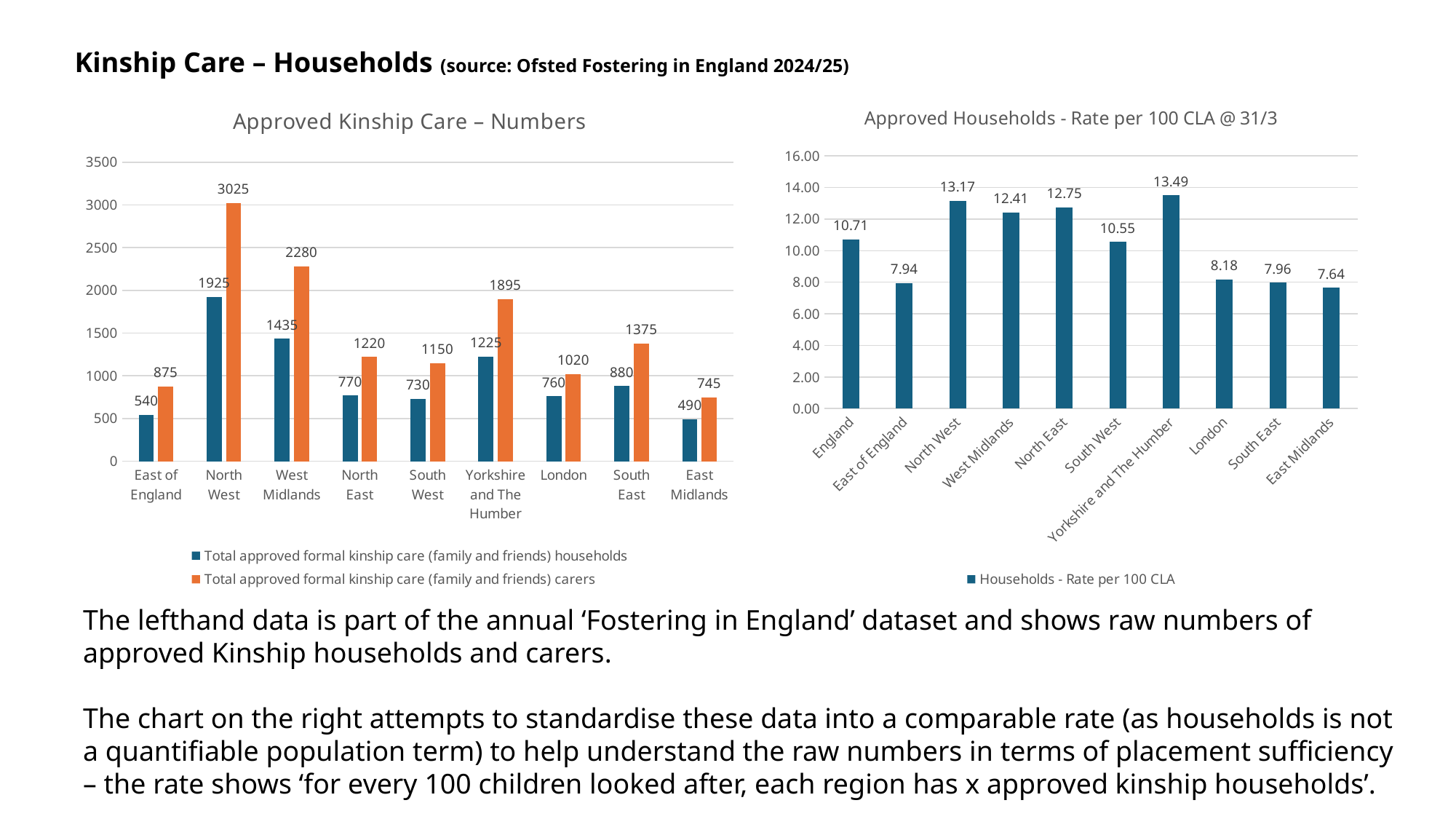
In the 'Approved Kinship Care – Numbers' chart, what is the value for total approved formal kinship care households in the North West? 1925 In the 'Approved Kinship Care – Numbers' chart, what is the difference between carers and households in the West Midlands? 845 In the 'Approved Kinship Care – Numbers' chart, how many series does the legend list? 2 In the 'Approved Kinship Care – Numbers' chart, how many regions are shown on the x axis? 9 In the 'Approved Households - Rate per 100 CLA @ 31/3' chart, which region has the highest rate? Yorkshire and The Humber In the 'Approved Households - Rate per 100 CLA @ 31/3' chart, is the rate for London larger or smaller than the rate for England? smaller In the 'Approved Kinship Care – Numbers' chart, what is the value for total approved formal kinship care carers in Yorkshire and The Humber? 1895 In the 'Approved Households - Rate per 100 CLA @ 31/3' chart, which region has the lowest rate? East Midlands In the 'Approved Kinship Care – Numbers' chart, which region has the lowest number of approved kinship care households? East Midlands In the 'Approved Households - Rate per 100 CLA @ 31/3' chart, what is the rate for the North East? 12.75 What kind of chart is the 'Approved Households - Rate per 100 CLA @ 31/3' chart? bar chart In the 'Approved Kinship Care – Numbers' chart, which region has the highest number of approved kinship care carers? North West